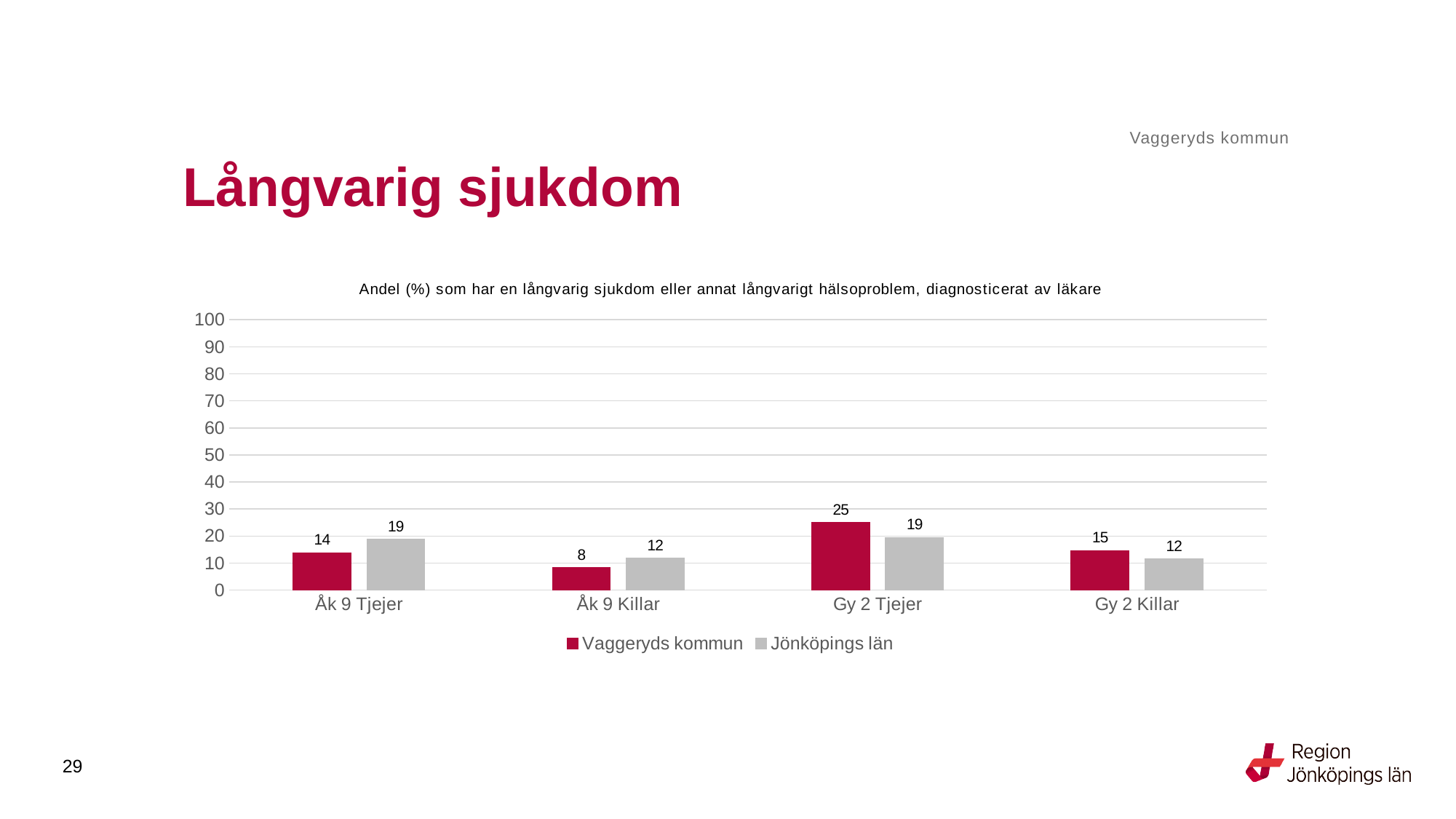
Is the value for Vaggeryds kommun in Gy 2 Tjejer greater or less than 20? greater What is the value for Jönköpings län in the Gy 2 Killar category? 12 What is the value for Vaggeryds kommun in the Åk 9 Tjejer category? 14 Which category has the highest value for Vaggeryds kommun? Gy 2 Tjejer Which category has the lowest value for Vaggeryds kommun? Åk 9 Killar How many series does the legend list? 2 Which is larger in the Åk 9 Tjejer category: Vaggeryds kommun or Jönköpings län? Jönköpings län What is the difference between Vaggeryds kommun and Jönköpings län in the Gy 2 Tjejer category? 6 What is the value for Vaggeryds kommun in the Åk 9 Killar category? 8 What kind of chart is shown on the slide? Bar chart Which series is shown in grey in the legend? Jönköpings län How many categories are shown on the x axis? 4